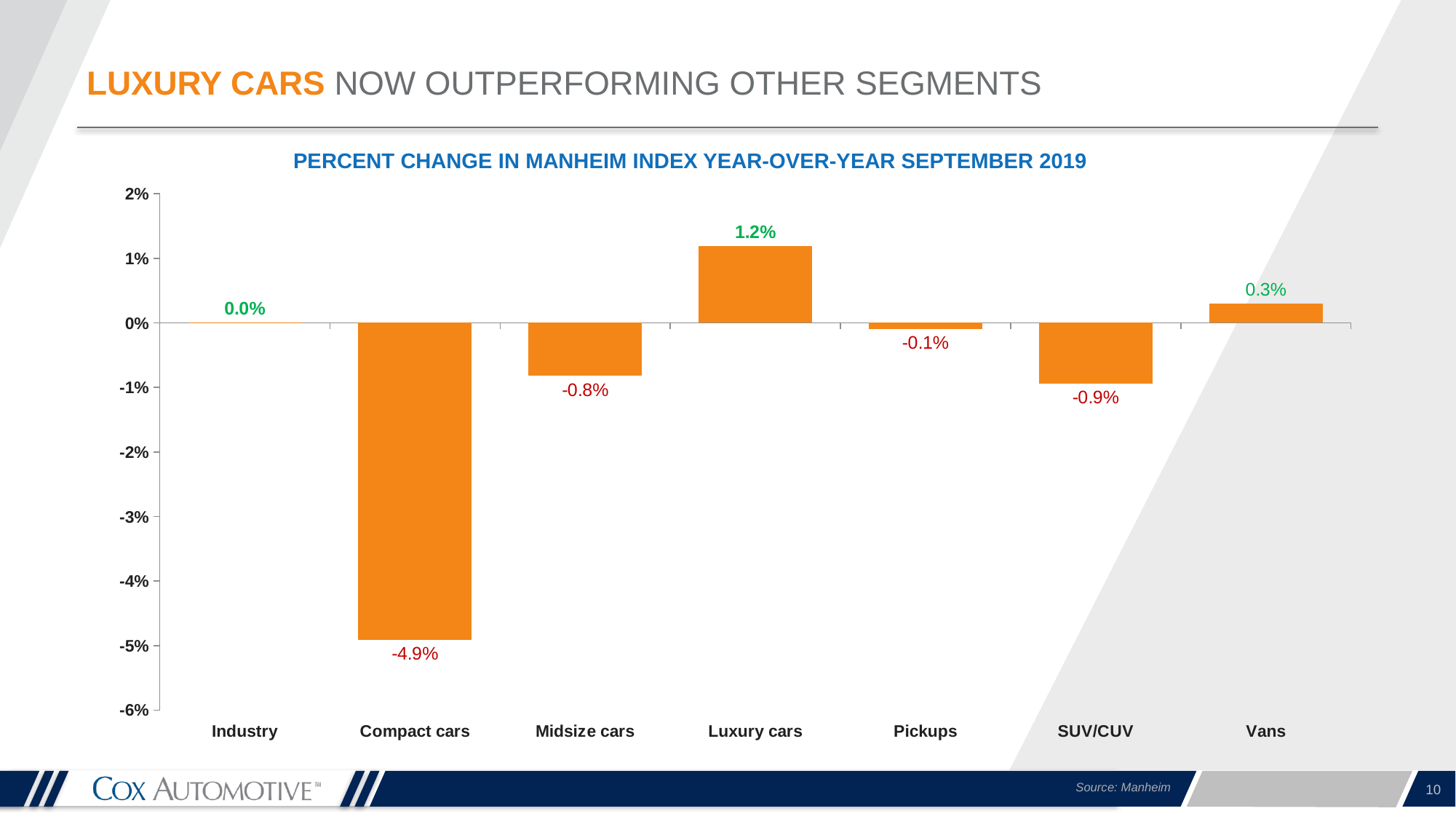
What is the percent change for Vans? 0.3% Which has a larger percent change, Midsize cars or Pickups? Pickups What kind of chart is shown on the slide? Bar chart What is the percent change for SUV/CUV? -0.9% What is the difference between the percent change for Luxury cars and Vans? 0.9% Which category has the lowest percent change? Compact cars What is the percent change for Compact cars? -4.9% How many categories are shown on the x axis? 7 Which category has the highest percent change? Luxury cars What is the title of the chart? PERCENT CHANGE IN MANHEIM INDEX YEAR-OVER-YEAR SEPTEMBER 2019 Is the value for Compact cars greater or less than -4%? less What is the percent change for Luxury cars? 1.2%